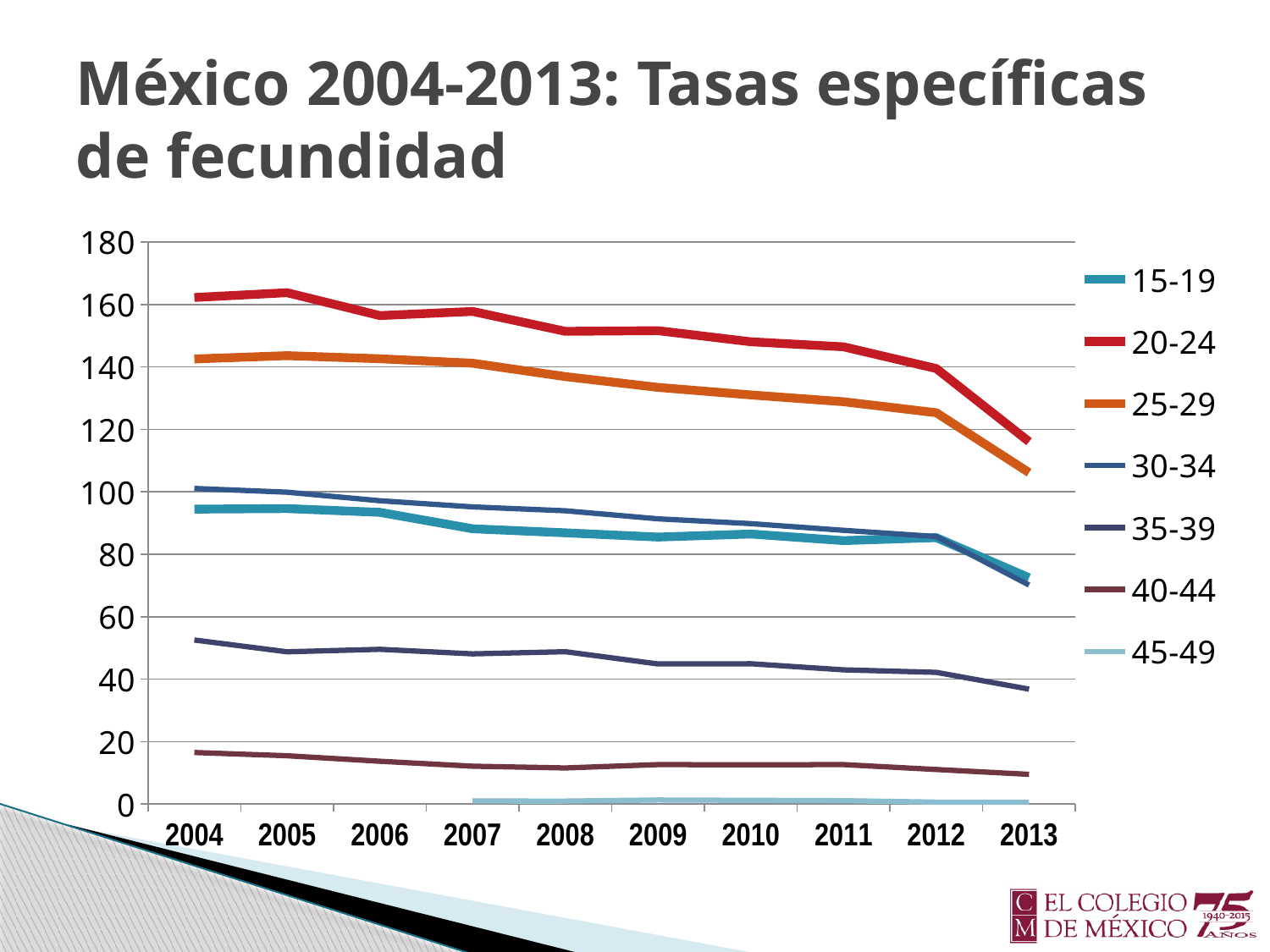
Which age group has the highest fertility rate across all years? 20-24 What is the title of the chart on the slide? México 2004-2013: Tasas específicas de fecundidad Is the value for 35-39 in 2004 greater or less than 40? greater How many series does the legend list? 7 What kind of chart is shown on the slide? line chart Is the value for 20-24 in 2013 greater or less than 100? greater How many years are plotted along the x axis? 10 Is the value for 15-19 in 2013 greater or less than 80? less Which age group has the lowest fertility rate across all years? 45-49 Does the value for the 20-24 series rise or fall from 2004 to 2013? fall In 2010, which series has the larger value, 35-39 or 40-44? 35-39